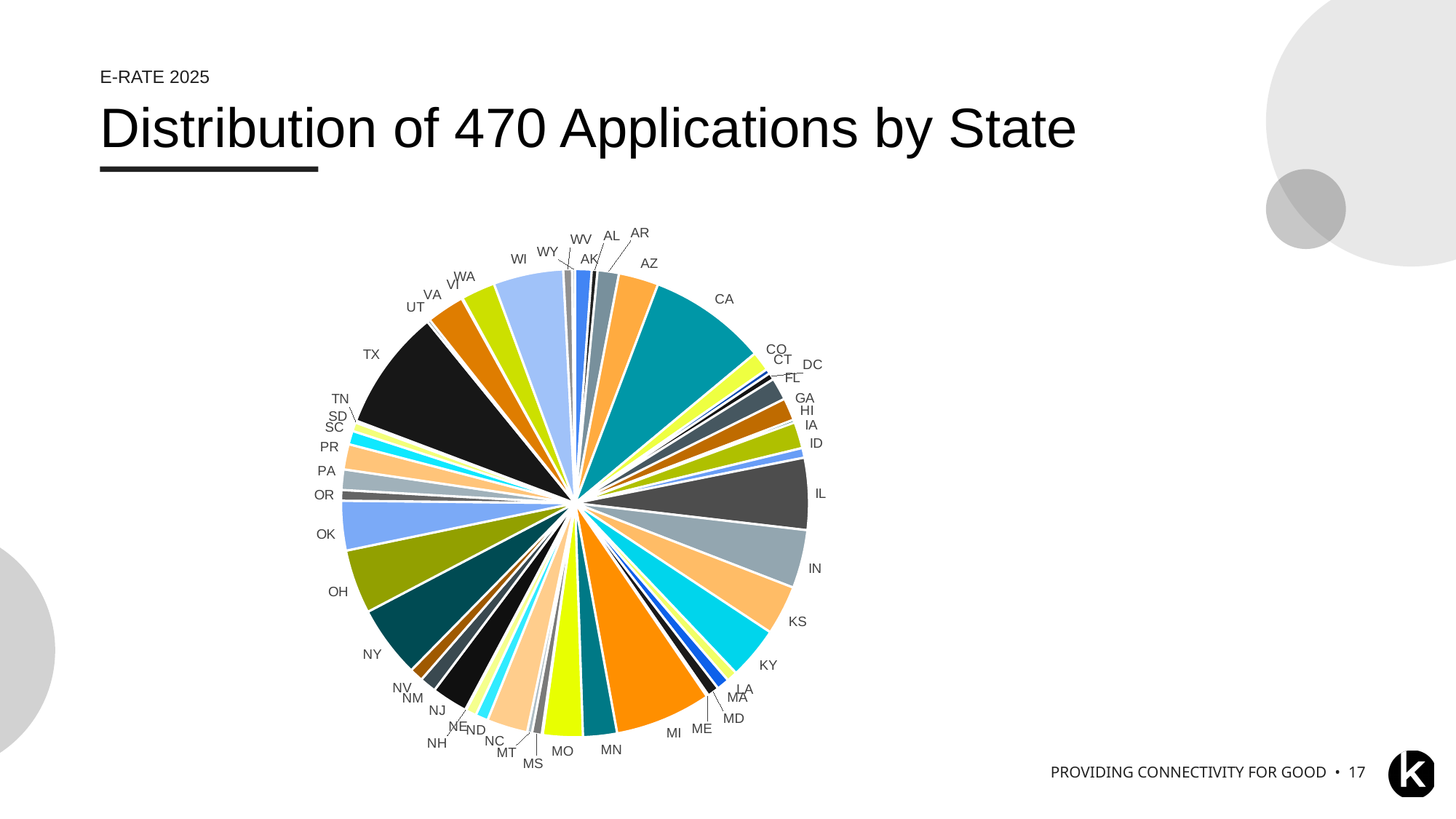
What is the title of the chart on the slide? Distribution of 470 Applications by State Which state's slice is larger, CA or IL? CA Which state's slice is larger, CA or AK? CA Which state's slice is larger, IL or DC? IL What kind of chart is shown on the slide? pie chart Which state is represented by the large black slice on the left side of the pie? TX